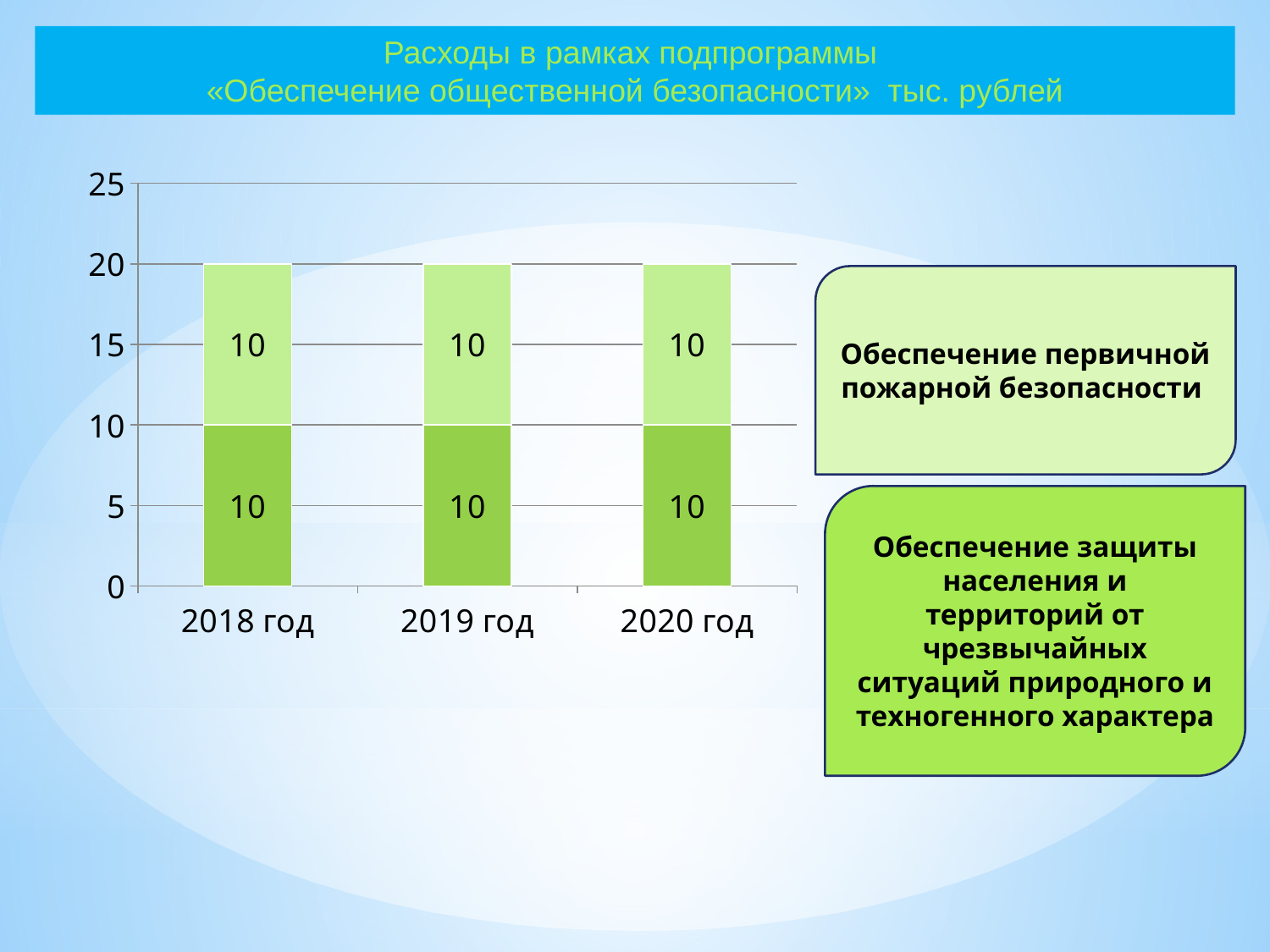
What is the value of the light green segment for 2019 год? 10 Is the total bar for 2019 год greater or less than 25? less What is the difference between the light green segment and the dark green segment for 2019 год? 0 What kind of chart is shown on the slide? Stacked bar chart Do the total bar heights rise, fall, or stay the same from 2018 год to 2020 год? Stay the same What is the value of the dark green segment (Обеспечение защиты населения и территорий от чрезвычайных ситуаций) for 2020 год? 10 What is the value of the light green segment (Обеспечение первичной пожарной безопасности) for 2018 год? 10 How many series are stacked in each bar? 2 What is the total of the stacked bar for 2018 год? 20 What is the total of the stacked bar for 2020 год? 20 In what units are the expenses shown according to the slide title? тыс. рублей How many years (categories) are shown on the x axis? 3